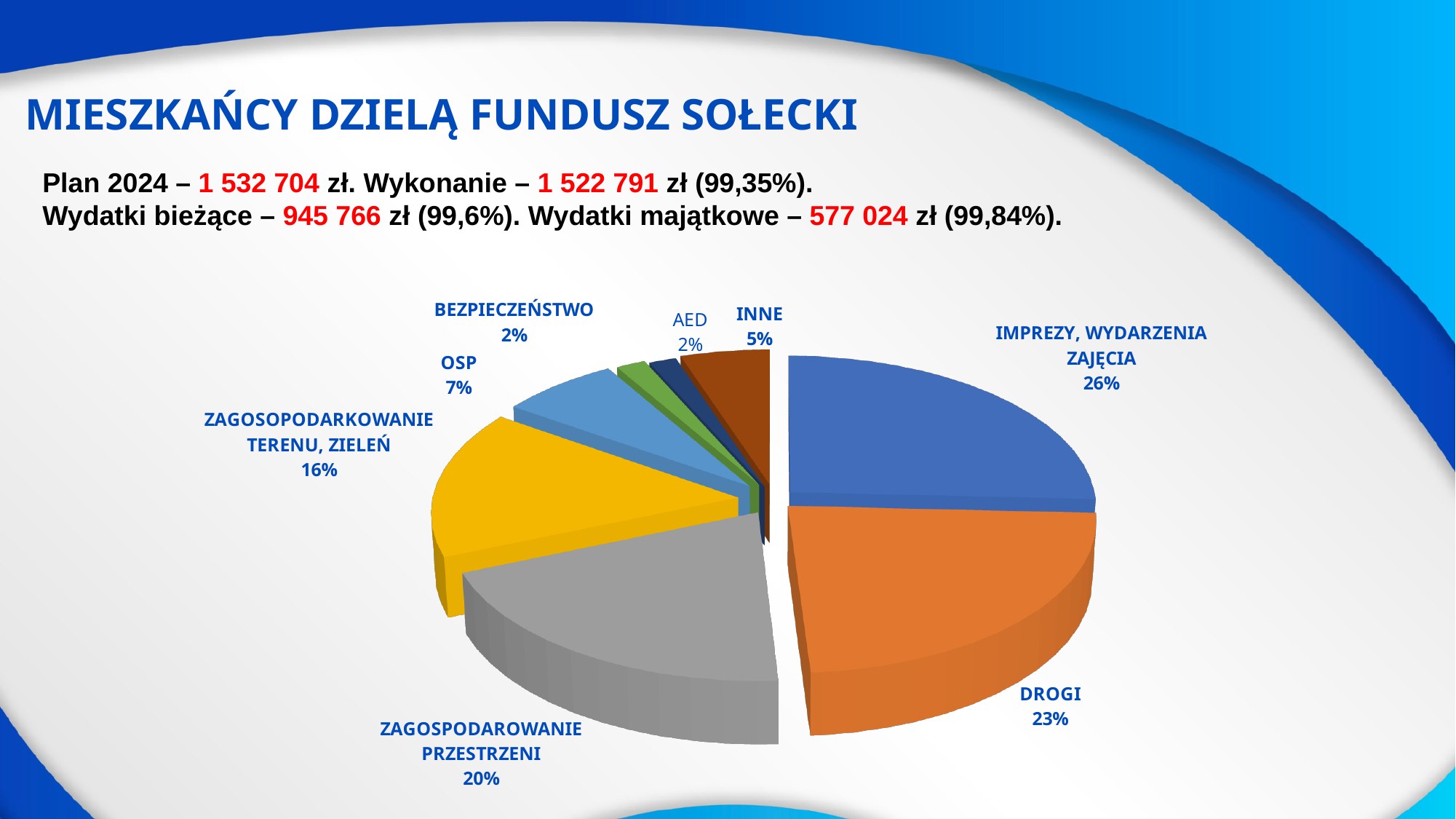
What colour is the DROGI slice? orange What is the value for ZAGOSOPODARKOWANIE TERENU, ZIELEŃ? 16% How many slices does the pie chart have? 8 What is the difference in percentage points between IMPREZY, WYDARZENIA ZAJĘCIA and DROGI? 3 What kind of chart is shown on the slide? pie chart Which category has the largest share of the pie? IMPREZY, WYDARZENIA ZAJĘCIA What percentage is shown for ZAGOSPODAROWANIE PRZESTRZENI? 20% What is the value shown for DROGI? 23% What percentage is shown for OSP? 7% Which is larger, the share for DROGI or the share for ZAGOSPODAROWANIE PRZESTRZENI? DROGI What is the value shown for INNE? 5% What share of the pie does IMPREZY, WYDARZENIA ZAJĘCIA represent? 26%